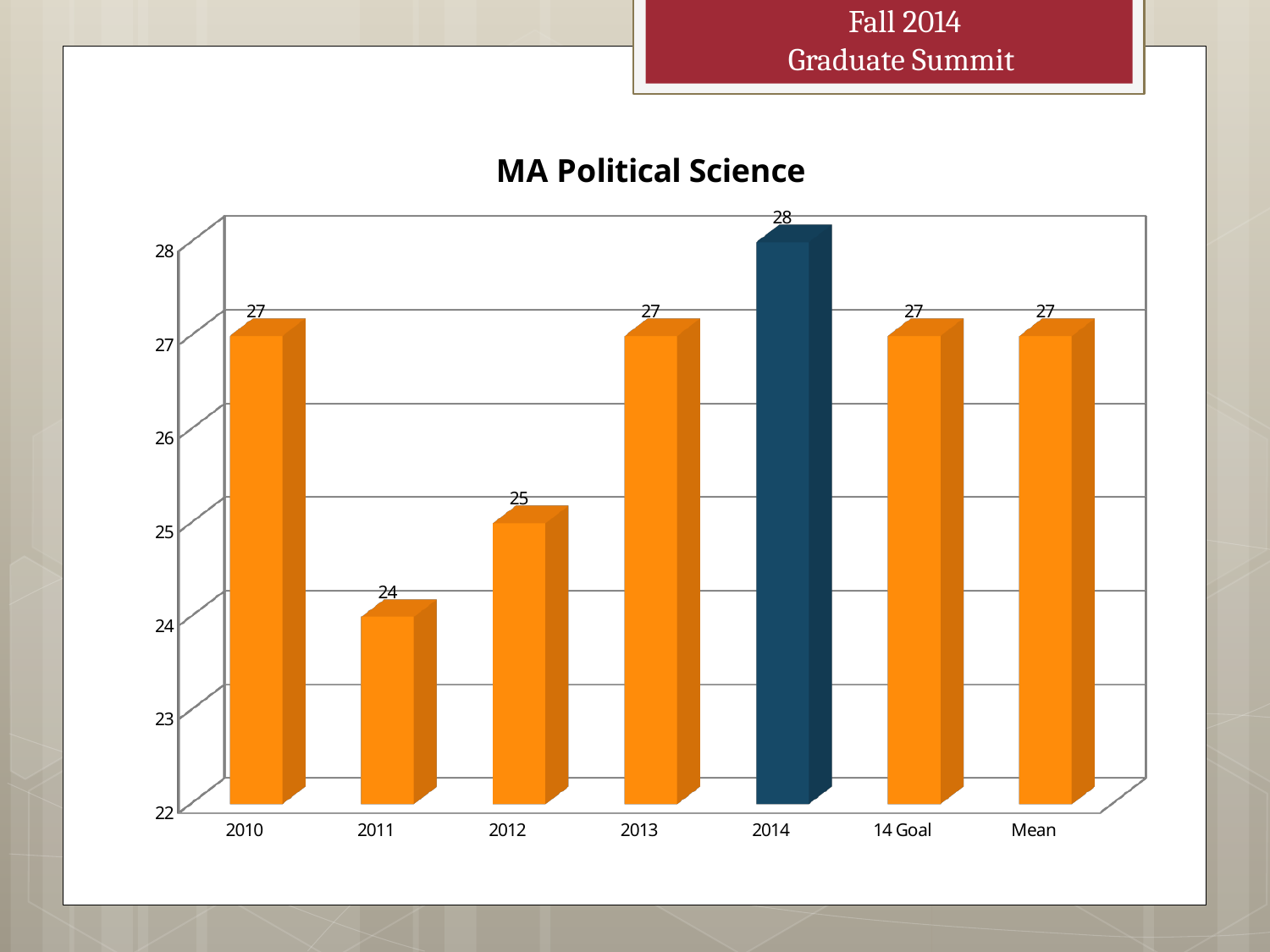
Which category has the highest value? 2014 Which is larger, the value for 2012 or the value for 2013? 2013 What is the difference between the values for 2014 and 2011? 4 What is the value for 2014? 28 What is the value for 2012? 25 What kind of chart is this? Bar chart How many categories are shown on the x axis? 7 What is the title of the chart? MA Political Science Which category has the lowest value? 2011 What is the value for 2010? 27 What is the value for 14 Goal? 27 What is the value for 2011? 24